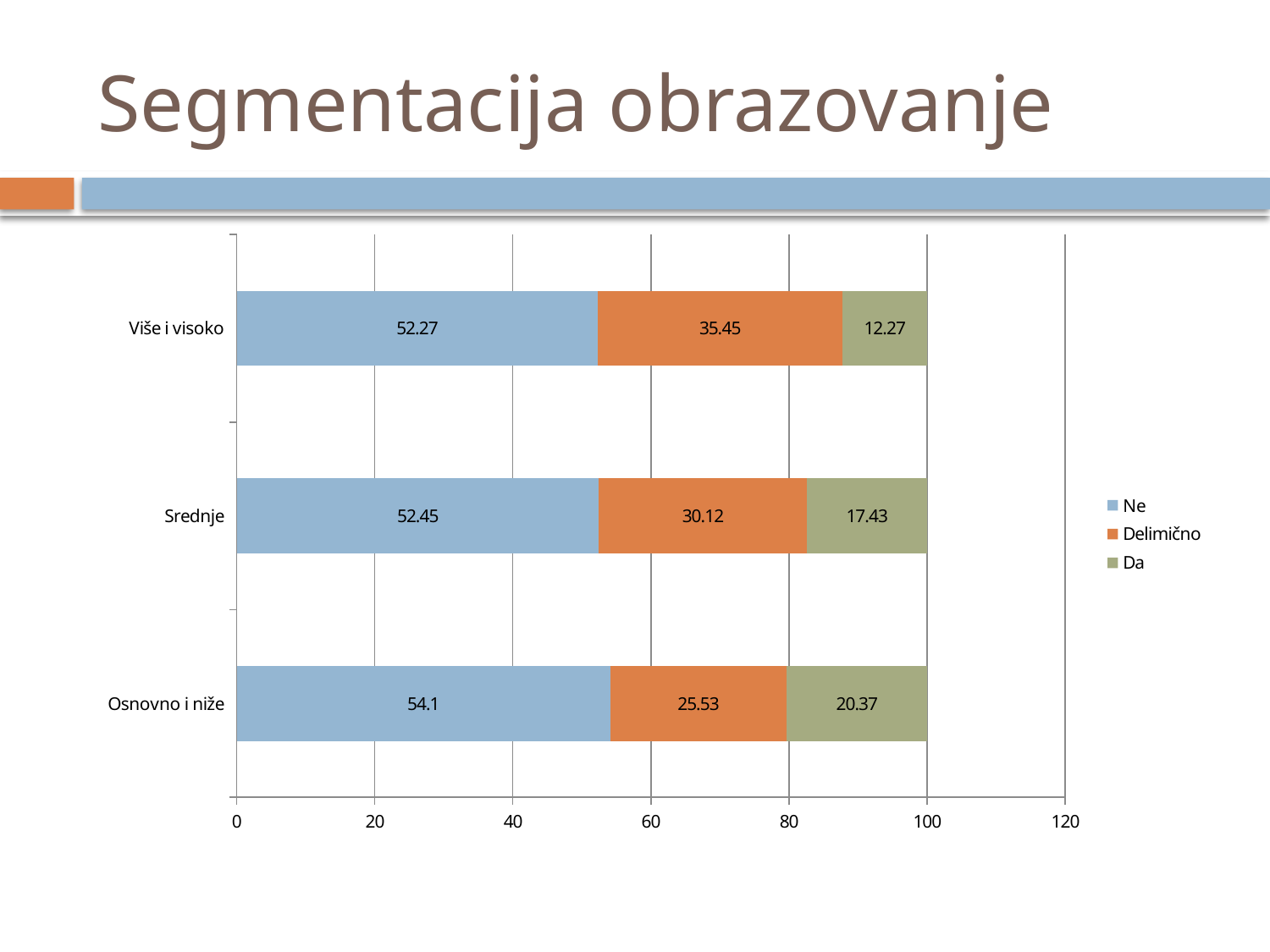
How many series does the legend list? 3 What is the difference between the "Delimično" values for Više i visoko and Srednje? 5.33 Which category has the lowest value for "Delimično"? Osnovno i niže What is the value of "Ne" for Srednje? 52.45 What kind of chart is shown on the slide? Stacked bar chart Which series is shown in orange in the legend? Delimično What is the total of the stacked bar for Srednje? 100 How many categories are shown on the chart? 3 What is the value of "Da" for Osnovno i niže? 20.37 Which category has the highest value for "Da"? Osnovno i niže Which is larger: the "Ne" value for Osnovno i niže or the "Ne" value for Više i visoko? Osnovno i niže What is the value of "Delimično" for Više i visoko? 35.45